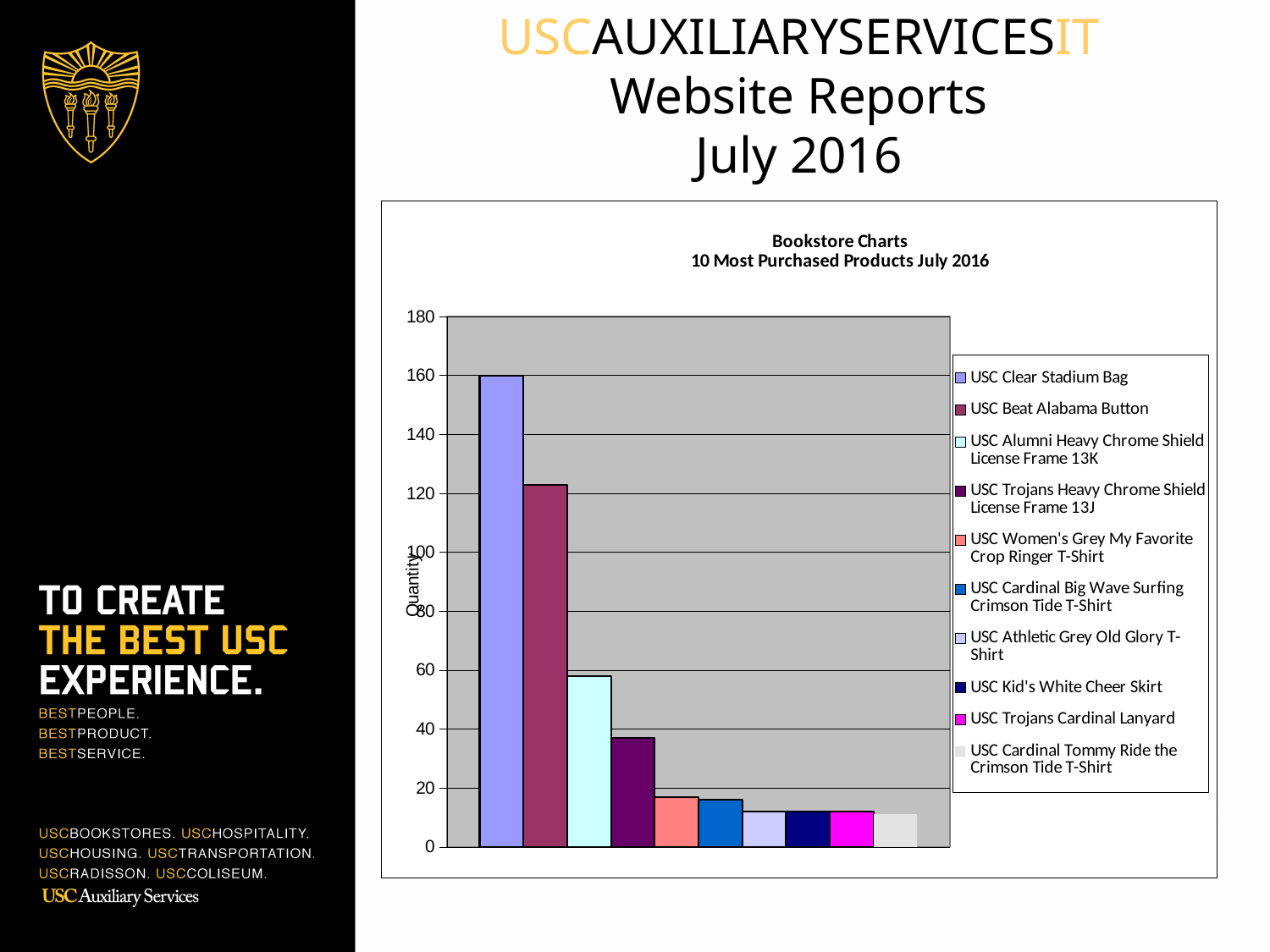
Is the value for USC Beat Alabama Button greater or less than 140? less What kind of chart is shown on the slide? bar chart Do the bar values rise or fall from left to right across the chart? fall Is the value for USC Clear Stadium Bag greater or less than 140? greater Which product has the highest quantity? USC Clear Stadium Bag Is the value for USC Beat Alabama Button greater or less than 100? greater What is the label on the vertical axis of the chart? Quantity Which has the larger quantity, USC Trojans Heavy Chrome Shield License Frame 13J or USC Women's Grey My Favorite Crop Ringer T-Shirt? USC Trojans Heavy Chrome Shield License Frame 13J How many products does the legend list? 10 Which has the larger quantity, USC Beat Alabama Button or USC Alumni Heavy Chrome Shield License Frame 13K? USC Beat Alabama Button